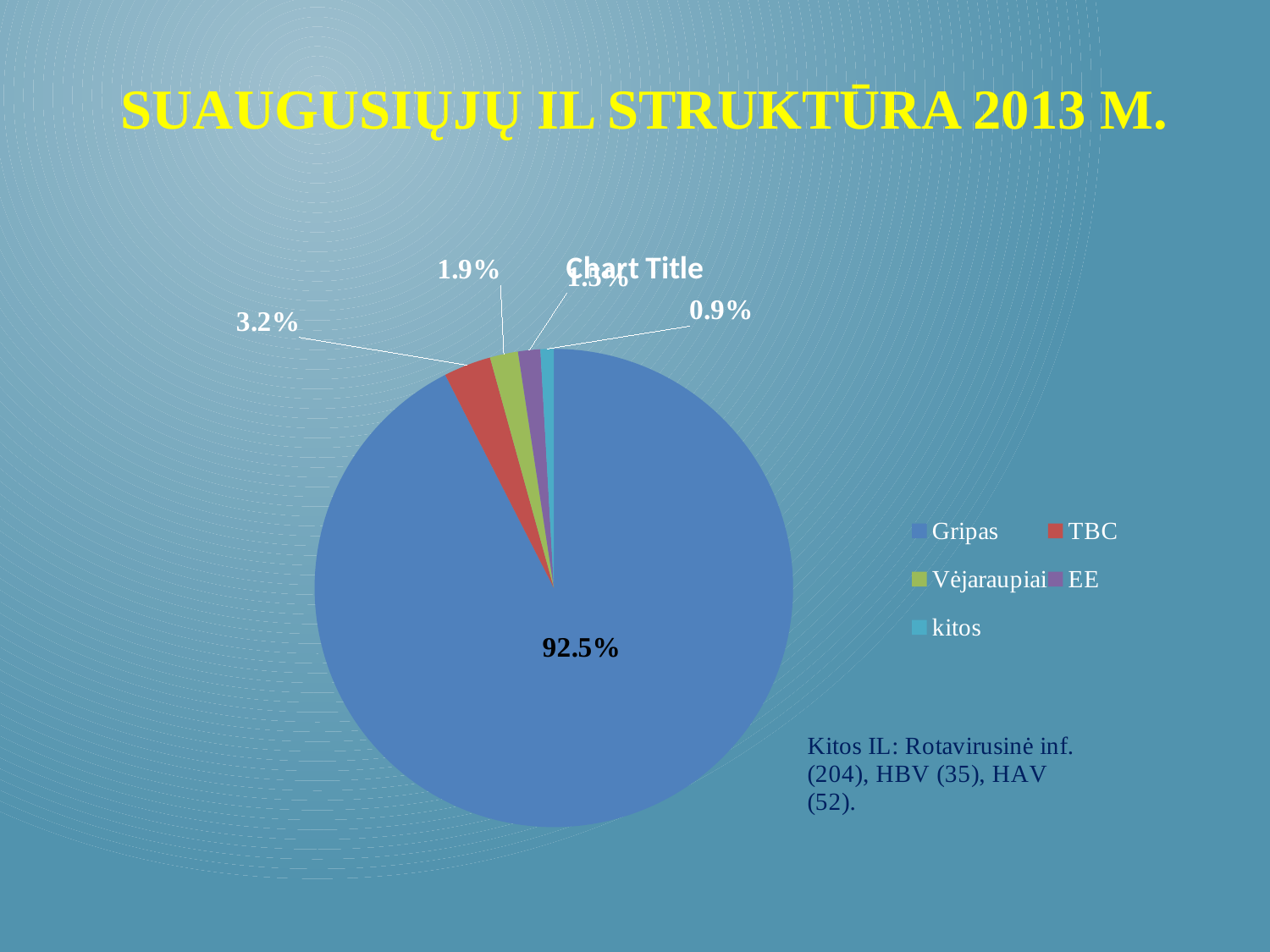
What is the value shown for Vėjaraupiai? 1.9% Which category has the smallest slice of the pie? kitos What is the difference between the Gripas value and the TBC value? 89.3% Which is larger, the slice for TBC or the slice for Vėjaraupiai? TBC How many categories does the legend list? 5 What is the value shown for kitos? 0.9% Which category has the largest slice of the pie? Gripas What share of the pie does Gripas account for? 92.5% What is the value shown for TBC? 3.2% What kind of chart is shown on the slide? pie chart What is the difference between the TBC value and the Vėjaraupiai value? 1.3% What title is printed above the pie chart? Chart Title